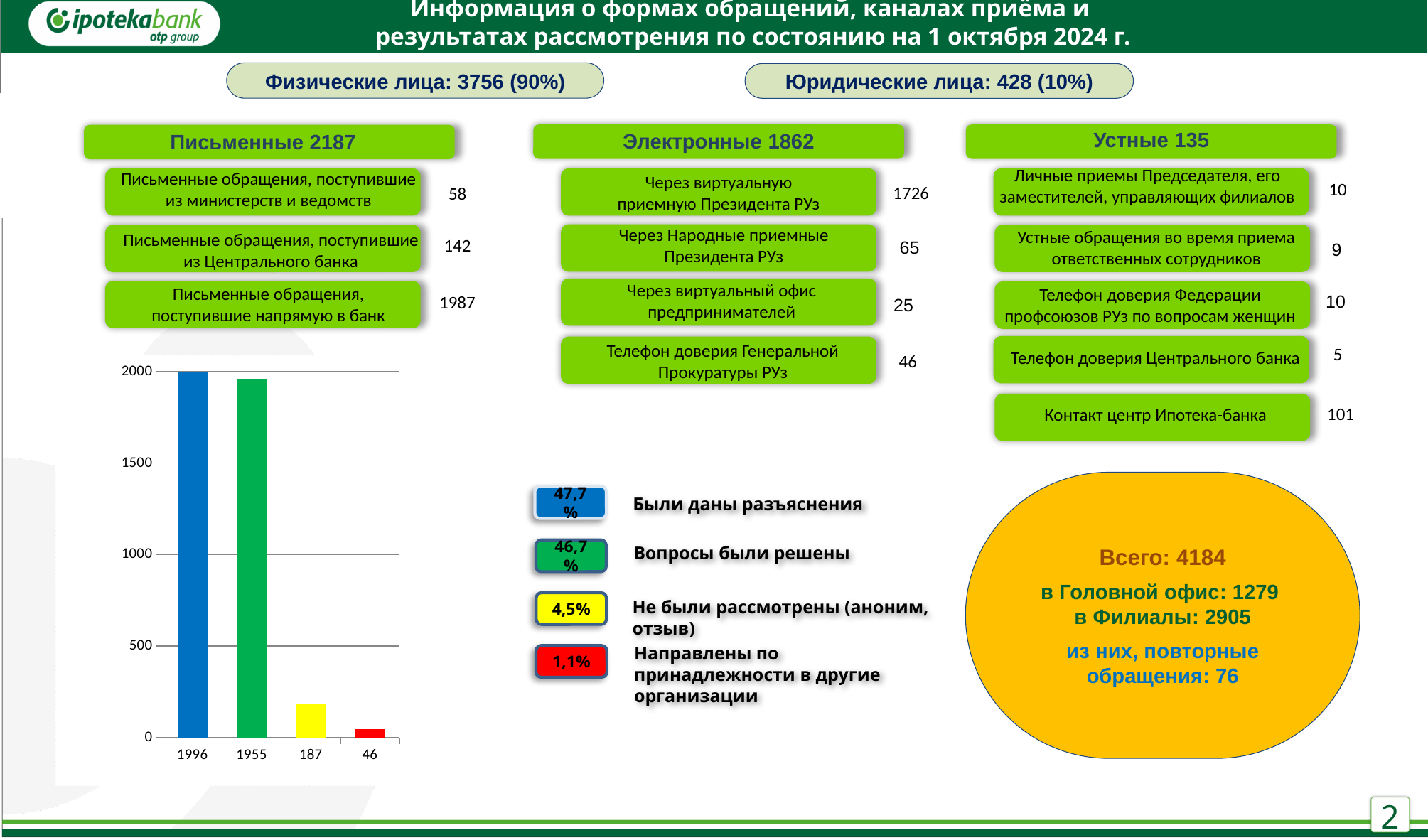
What label appears on the x axis under the yellow bar? 187 Is the value of the yellow bar greater or less than 500? less Which bar in the bar chart is the lowest? the red bar (46) Is the value of the green bar greater or less than 1000? greater What colour is the tallest bar in the bar chart? blue What kind of chart is shown on the slide? bar chart Which is larger in the bar chart, the green bar or the yellow bar? the green bar How many bars does the bar chart have? 4 Is the value of the red bar greater or less than 500? less Which is larger in the bar chart, the yellow bar or the red bar? the yellow bar What label appears on the x axis under the blue bar? 1996